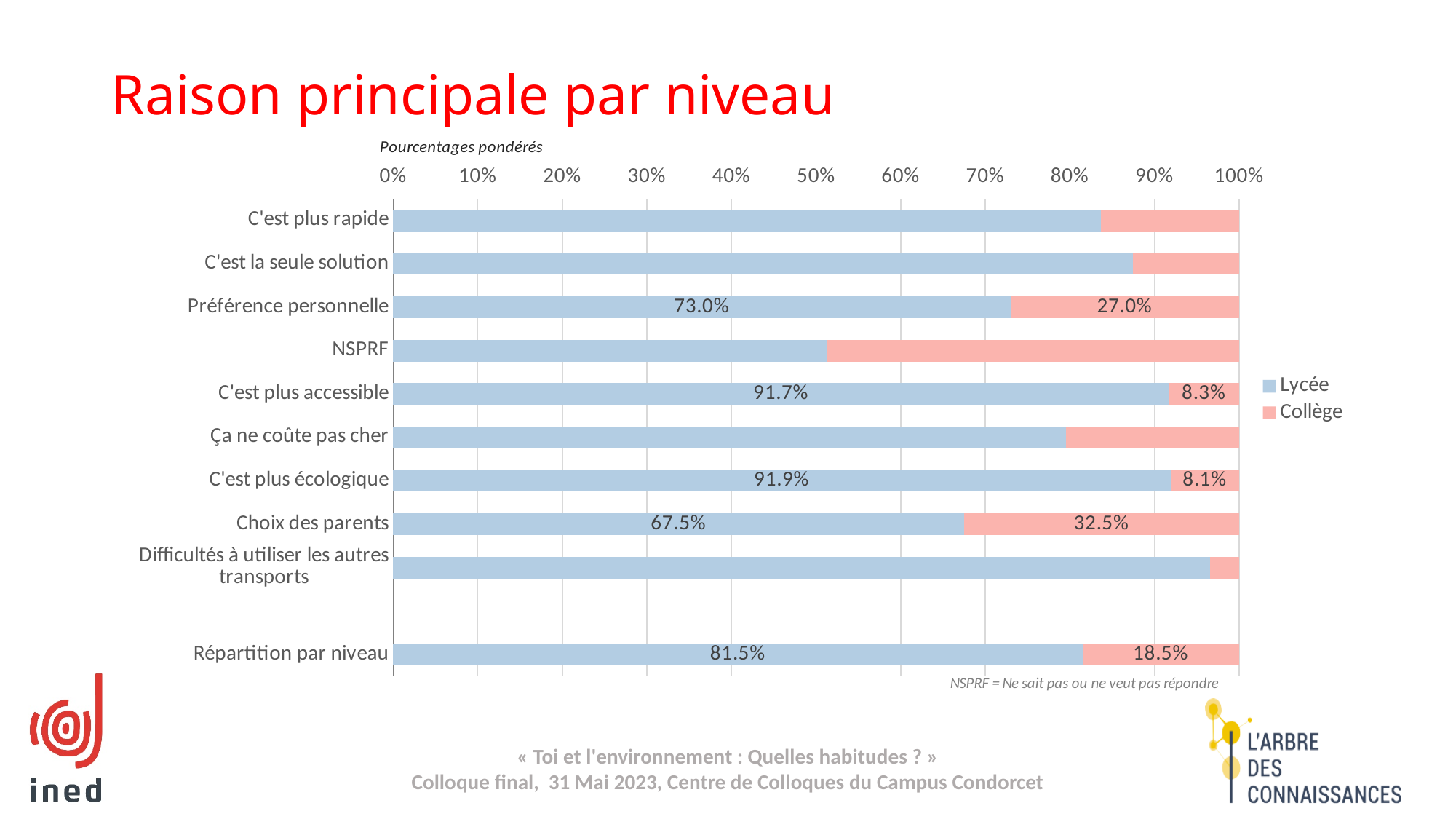
What is the Lycée value for Préférence personnelle? 73.0% What kind of chart is shown? Stacked bar chart Which category has the lowest Lycée share? NSPRF Which is larger, the Collège value for Choix des parents or for Préférence personnelle? Choix des parents What is the Collège value for Choix des parents? 32.5% Is the Lycée value for C'est plus rapide greater or less than 80%? greater What is the Collège value for C'est plus accessible? 8.3% Which category has the highest Lycée share? Difficultés à utiliser les autres transports What is the Lycée value for Répartition par niveau? 81.5% How many series does the legend list? 2 What is the difference between the Lycée values for Préférence personnelle and Choix des parents? 5.5 percentage points How many categories are shown on the y axis? 10